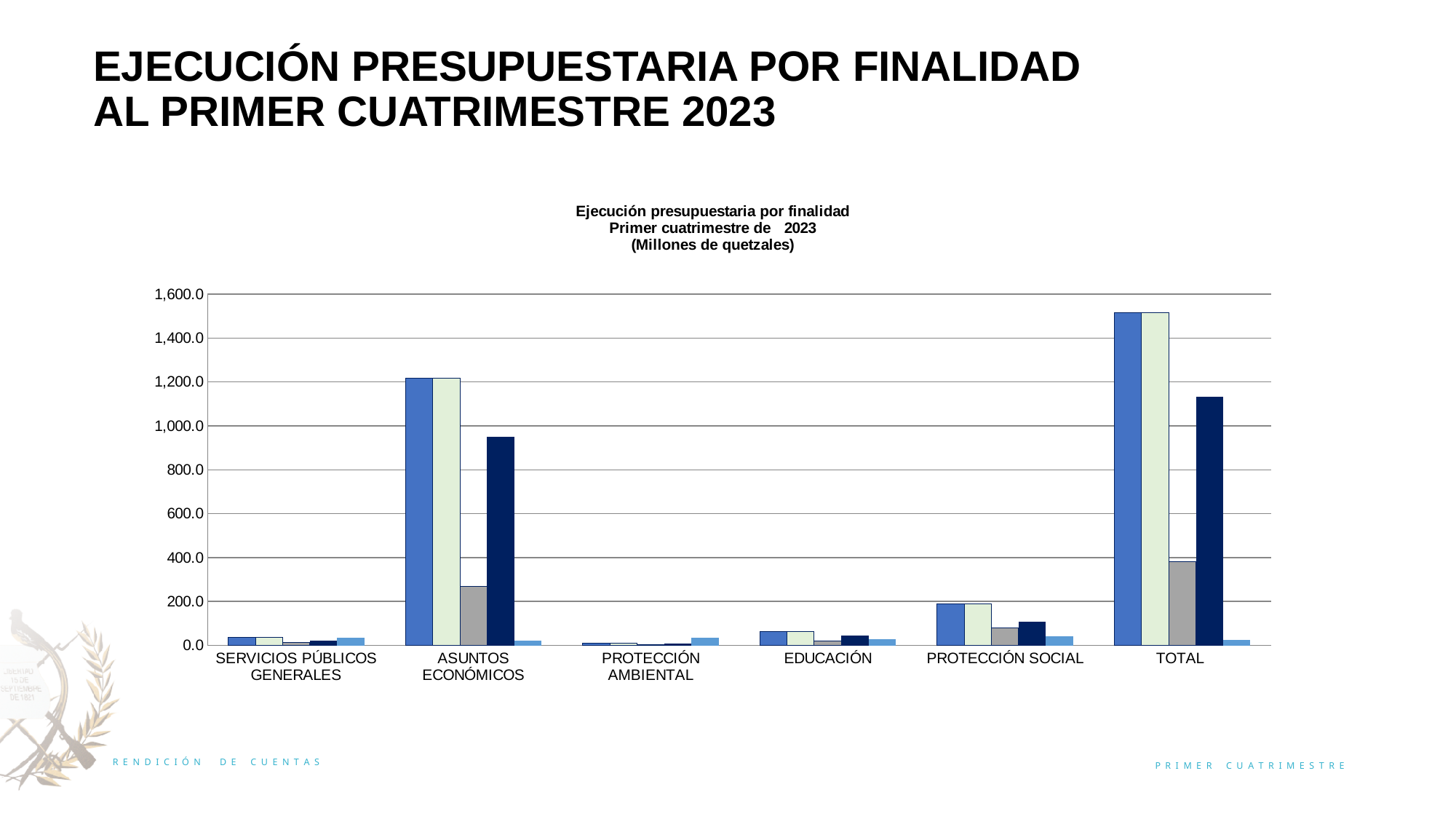
In what units are the values of the chart expressed, according to its title? Millones de quetzales Is the tallest bar for ASUNTOS ECONÓMICOS greater or less than 1,000.0? greater Which category has taller bars, ASUNTOS ECONÓMICOS or PROTECCIÓN SOCIAL? ASUNTOS ECONÓMICOS How many categories are shown on the x axis of the chart? 6 Is the dark navy bar for TOTAL greater or less than 1,000.0? greater Excluding TOTAL, which category has the lowest bars in the chart? PROTECCIÓN AMBIENTAL What kind of chart is shown on the slide? bar chart Which category has the tallest bars in the chart? TOTAL Is the tallest bar for EDUCACIÓN greater or less than 200.0? less How many bars are plotted for each category in the chart? 5